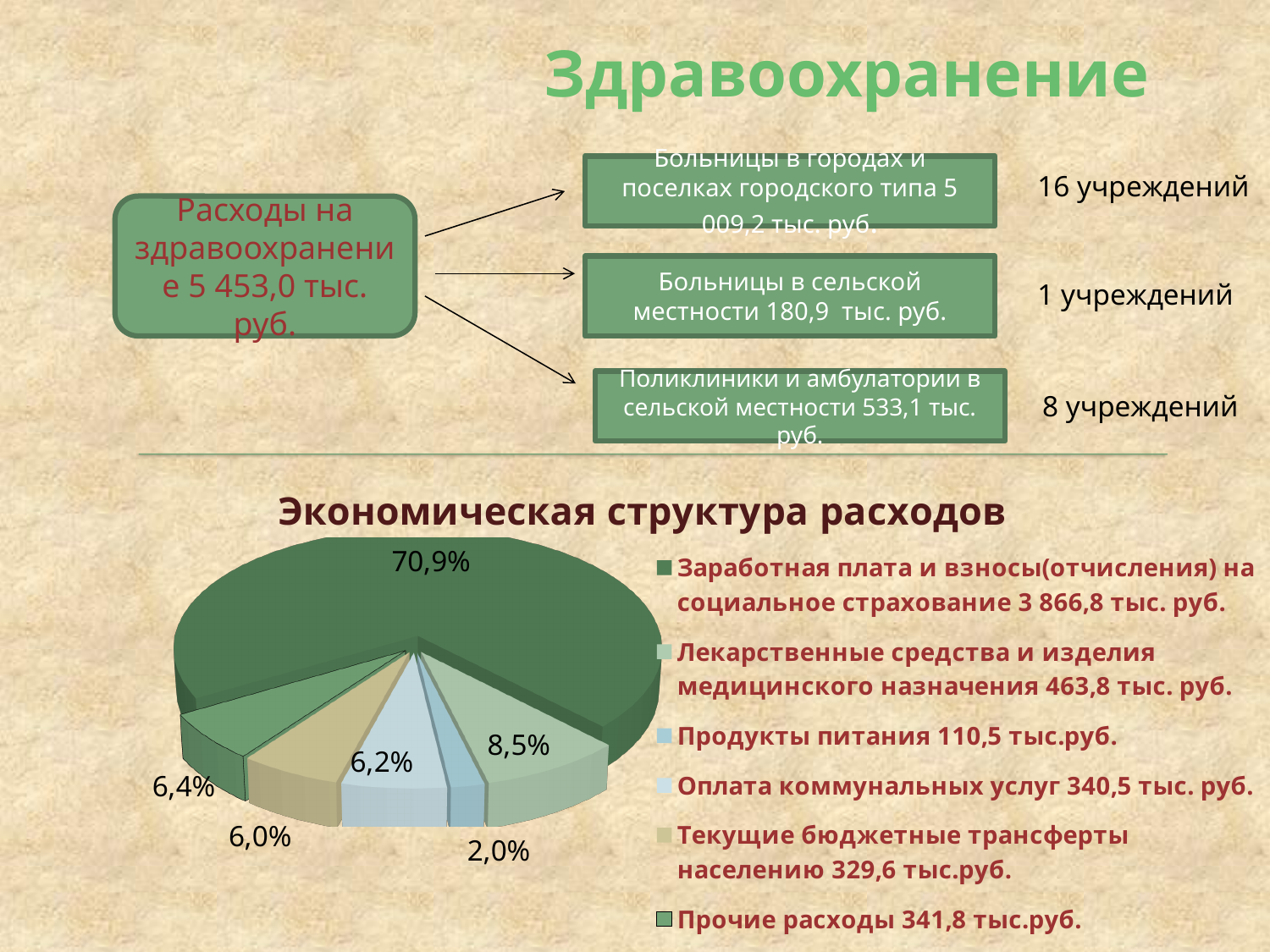
What share of the pie is "Оплата коммунальных услуг"? 6,2% How many slices does the pie chart have? 6 Which slice is larger: "Лекарственные средства и изделия медицинского назначения" or "Текущие бюджетные трансферты населению"? Лекарственные средства и изделия медицинского назначения By how many percentage points does the wages slice (70,9%) exceed the medicines slice (8,5%)? 62,4% What kind of chart is shown under the heading "Экономическая структура расходов"? pie chart What share of the pie is "Прочие расходы"? 6,4% Which category has the smallest slice of the pie? Продукты питания What is the title of the pie chart? Экономическая структура расходов What share of the pie is "Заработная плата и взносы(отчисления) на социальное страхование"? 70,9% Which category has the largest slice of the pie? Заработная плата и взносы(отчисления) на социальное страхование